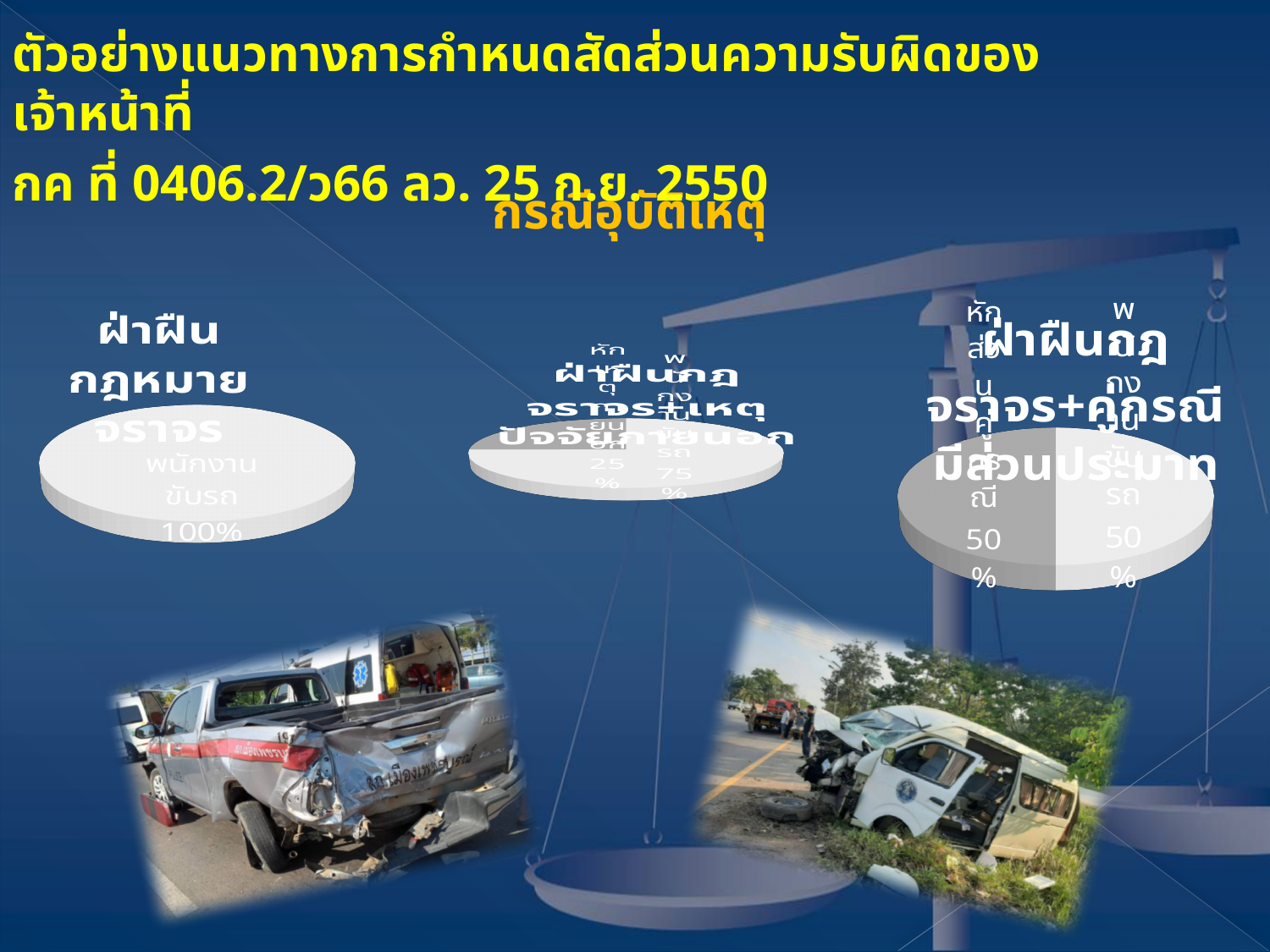
In the right chart, is the share for คู่กรณี larger than, smaller than, or equal to the share for พนักงานขับรถ? Equal In the middle chart (ฝ่าฝืนกฎจราจร+เหตุปัจจัยภายนอก), what is the value of the smallest slice? 25% What is the title of the left pie chart? ฝ่าฝืนกฎหมายจราจร What kind of chart is the left chart titled ฝ่าฝืนกฎหมายจราจร? Pie chart How many pie charts are shown on the slide? 3 How many slices does the left chart (ฝ่าฝืนกฎหมายจราจร) have? 1 In the left chart (ฝ่าฝืนกฎหมายจราจร), what share is assigned to พนักงานขับรถ? 100% How many slices does the right chart (ฝ่าฝืนกฎจราจร+คู่กรณีมีส่วนประมาท) have? 2 In the middle chart (ฝ่าฝืนกฎจราจร+เหตุปัจจัยภายนอก), what is the value of the largest slice? 75% What is the title of the right pie chart? ฝ่าฝืนกฎจราจร+คู่กรณีมีส่วนประมาท In the right chart (ฝ่าฝืนกฎจราจร+คู่กรณีมีส่วนประมาท), what share is assigned to คู่กรณี? 50% In the right chart (ฝ่าฝืนกฎจราจร+คู่กรณีมีส่วนประมาท), what share is assigned to พนักงานขับรถ? 50%